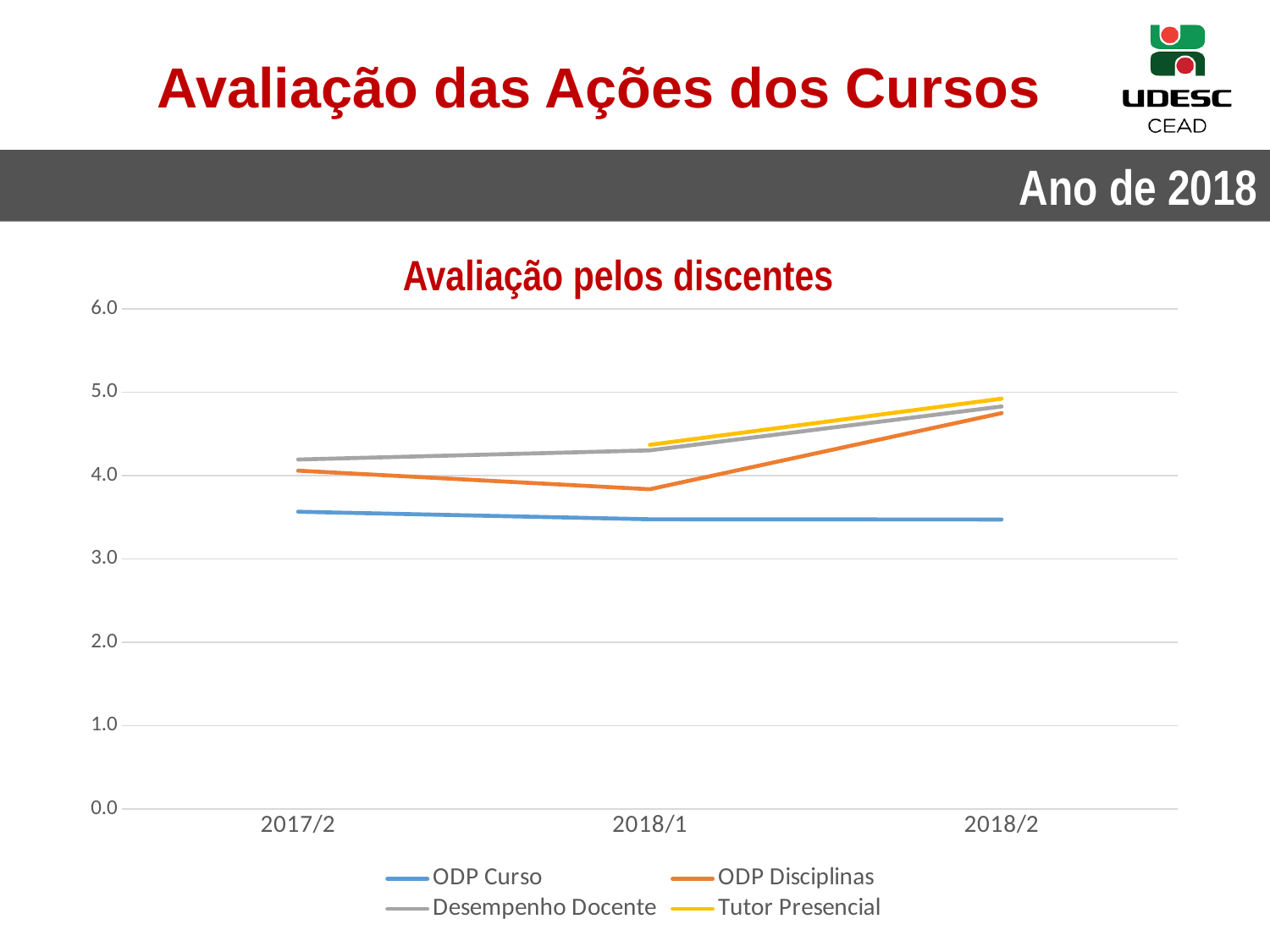
Which series has data only from 2018/1 onward? Tutor Presencial Is the value for ODP Disciplinas in 2018/2 greater or less than 4.0? greater Is the value for ODP Disciplinas in 2018/1 greater or less than 4.0? less Which series has the lowest value in 2018/2? ODP Curso Does the ODP Disciplinas line rise or fall from 2018/1 to 2018/2? Rise How many periods are shown on the x axis? 3 Does the Desempenho Docente line rise or fall from 2017/2 to 2018/2? Rise What is the title of the chart? Avaliação pelos discentes What kind of chart is shown on the slide? Line chart Is the value for ODP Curso in 2017/2 greater or less than 4.0? less In 2017/2, which is larger: Desempenho Docente or ODP Curso? Desempenho Docente How many series does the legend list? 4